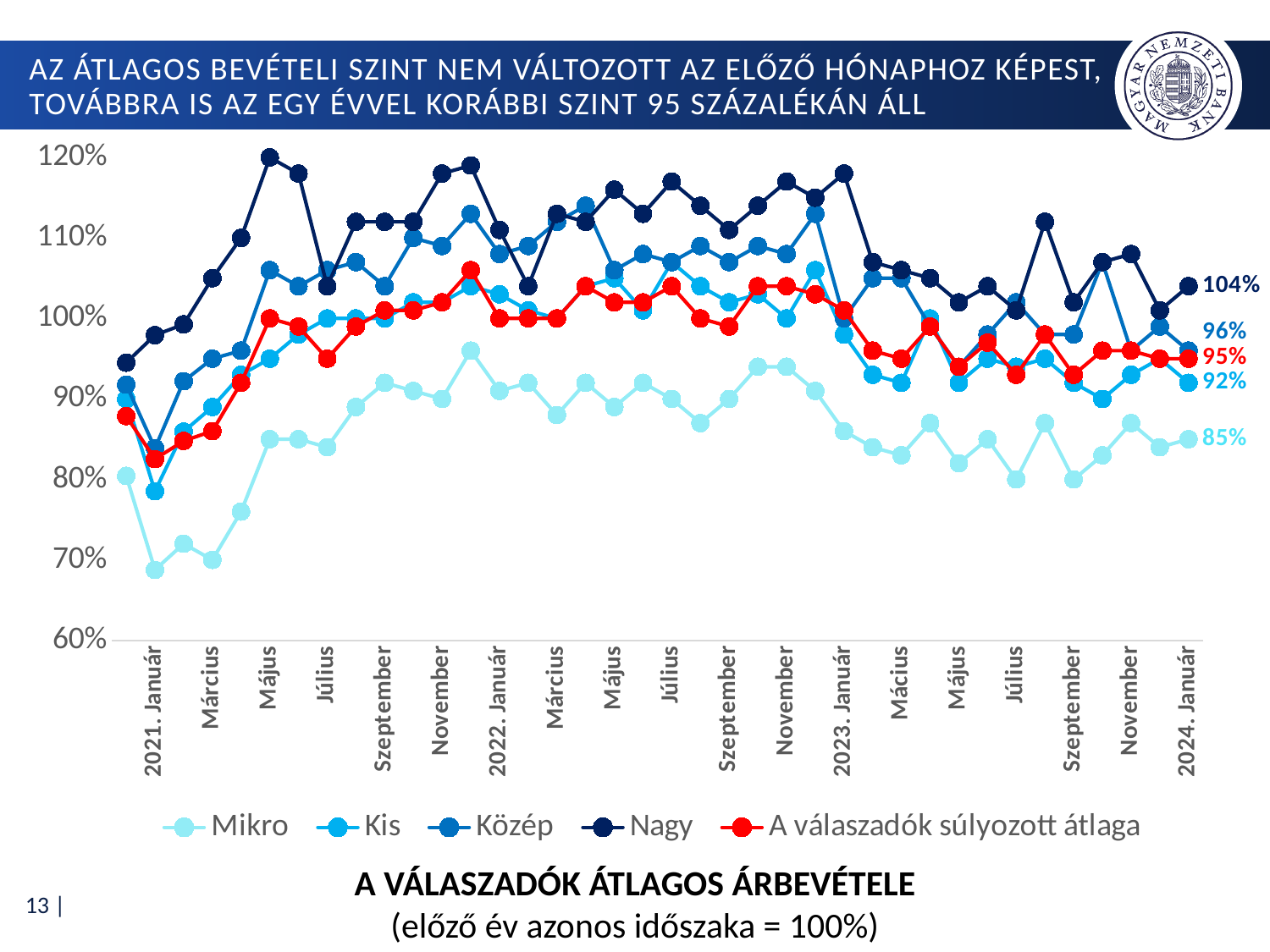
Is the value for Nagy at 2021. Január greater or less than 100%? less Which series has the highest value at 2024. Január? Nagy What kind of chart is shown on the slide? Line chart What is the value for Nagy at 2024. Január? 104% At 2024. Január, which is larger: Kis or Közép? Közép What is the value for Mikro at 2024. Január? 85% What is the value for Kis at 2024. Január? 92% Which series has the lowest value at 2024. Január? Mikro How many series does the legend list? 5 Is the value for Nagy at 2023. Január greater or less than 110%? greater What is the difference between the Nagy and Mikro values at 2024. Január? 19 percentage points What is the value of A válaszadók súlyozott átlaga at 2024. Január? 95%